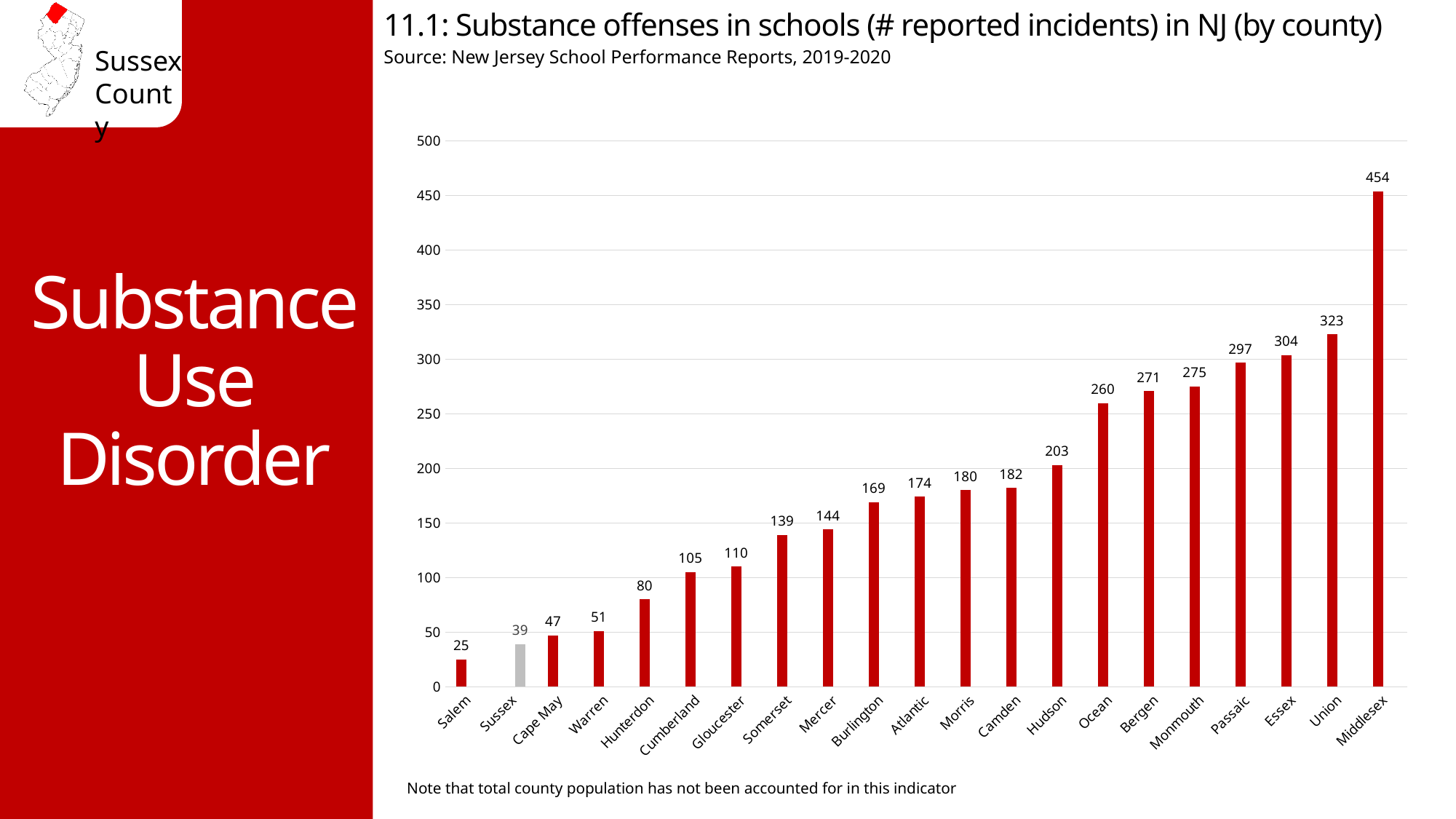
What is the difference between the values for Middlesex and Union? 131 Which county's bar is shown in grey rather than red? Sussex Which county has the highest number of reported substance offense incidents? Middlesex How many counties are shown on the x axis of the chart? 21 Which has a higher value, Ocean or Hudson? Ocean What is the value shown for Middlesex County? 454 What kind of chart is shown on the slide? Bar chart Which county has the lowest number of reported substance offense incidents? Salem How many reported incidents are shown for Hunterdon County? 80 What is the number of reported substance offense incidents in schools for Sussex County? 39 What is the difference between the values for Sussex and Salem? 14 Do the values rise or fall moving from left to right along the x axis? Rise